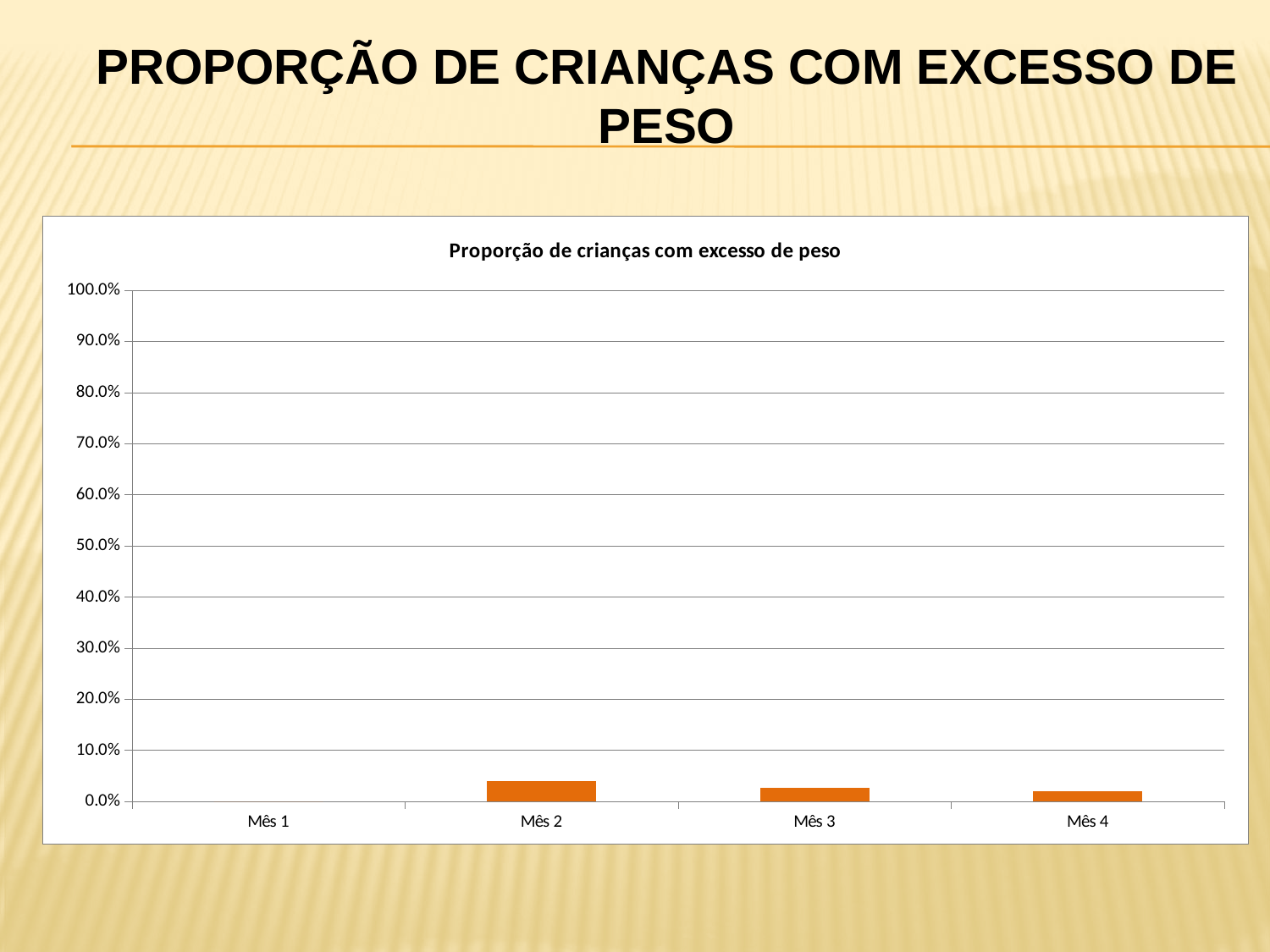
How many months are shown on the x axis of the chart? 4 Is the value for Mês 4 greater or less than 10.0%? less What is the title of the chart? Proporção de crianças com excesso de peso Which month has the highest proportion of children with excess weight? Mês 2 What kind of chart is shown on the slide? bar chart Is the value for Mês 2 greater or less than 10.0%? less Is the value for Mês 3 greater or less than 10.0%? less Which is larger, the value for Mês 2 or the value for Mês 4? Mês 2 Which month shows no visible bar in the chart? Mês 1 Do the values rise or fall from Mês 2 to Mês 4? fall Which is larger, the value for Mês 2 or the value for Mês 3? Mês 2